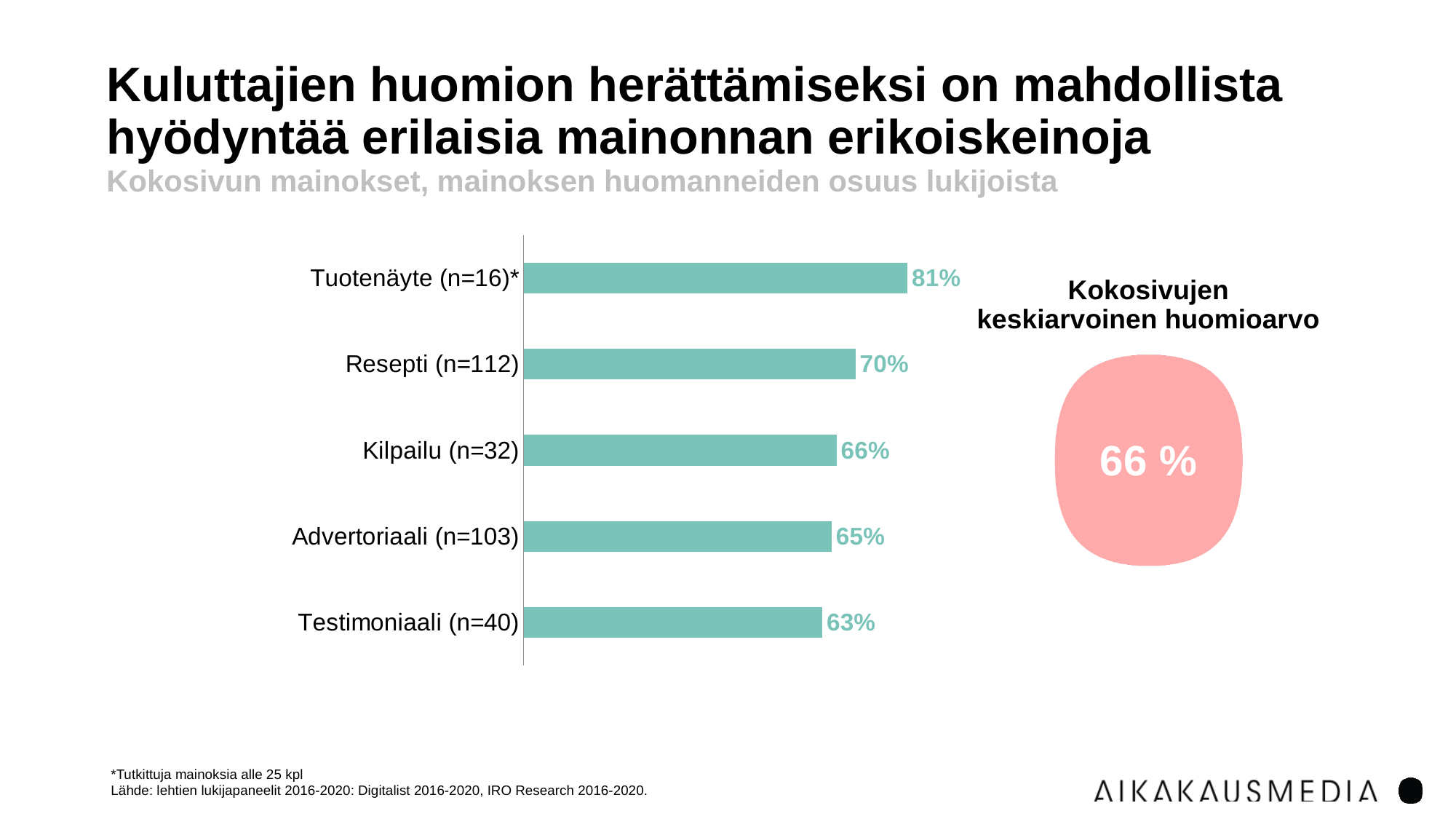
What is the difference between the values for Tuotenäyte (n=16)* and Testimoniaali (n=40)? 18% Which category has the highest value? Tuotenäyte (n=16)* What kind of chart is shown on the slide? Bar chart How many categories are shown in the bar chart? 5 What is the value for Advertoriaali (n=103)? 65% What is the value for Resepti (n=112)? 70% Which is larger, the value for Resepti (n=112) or the value for Kilpailu (n=32)? Resepti (n=112) What is the value for Tuotenäyte (n=16)*? 81% What average attention value (keskiarvoinen huomioarvo) is shown in the pink circle next to the chart? 66 % Which category has the lowest value? Testimoniaali (n=40) What is the value for Kilpailu (n=32)? 66% What is the value for Testimoniaali (n=40)? 63%